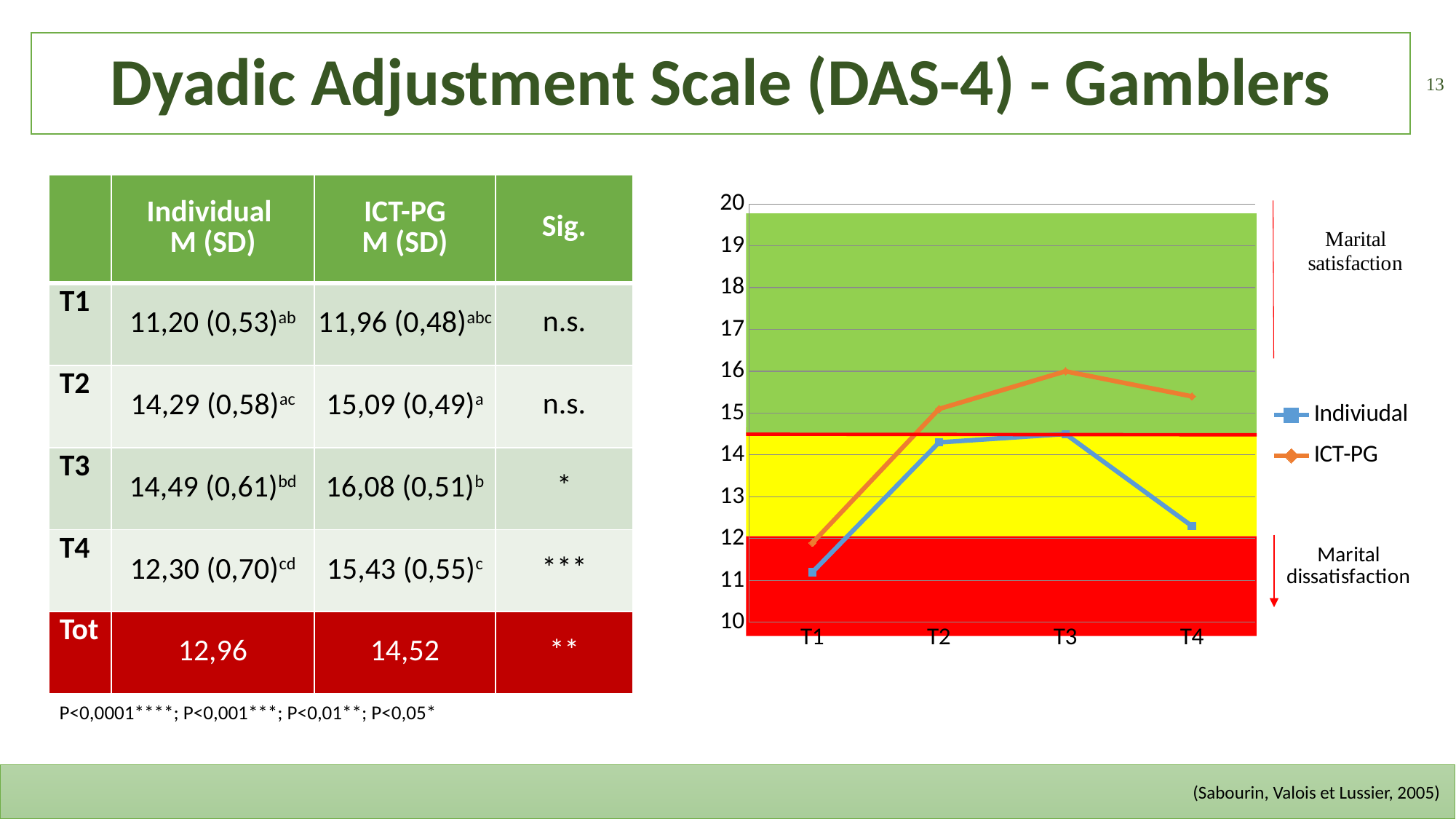
How many time points are plotted along the x axis of the chart? 4 Is the value for ICT-PG at T1 greater or less than 13? less Is the value for Individual at T4 greater or less than 13? less What kind of chart is shown on the slide? line chart Does the Individual series rise or fall from T3 to T4? fall How many series does the chart legend list? 2 At which time point is the Individual series at its lowest value? T1 Is the value for Individual at T1 greater or less than 12? less At which time point does the ICT-PG series reach its highest value? T3 At T4, which series has the higher value, Individual or ICT-PG? ICT-PG What are the two entries listed in the chart legend? Indiviudal and ICT-PG